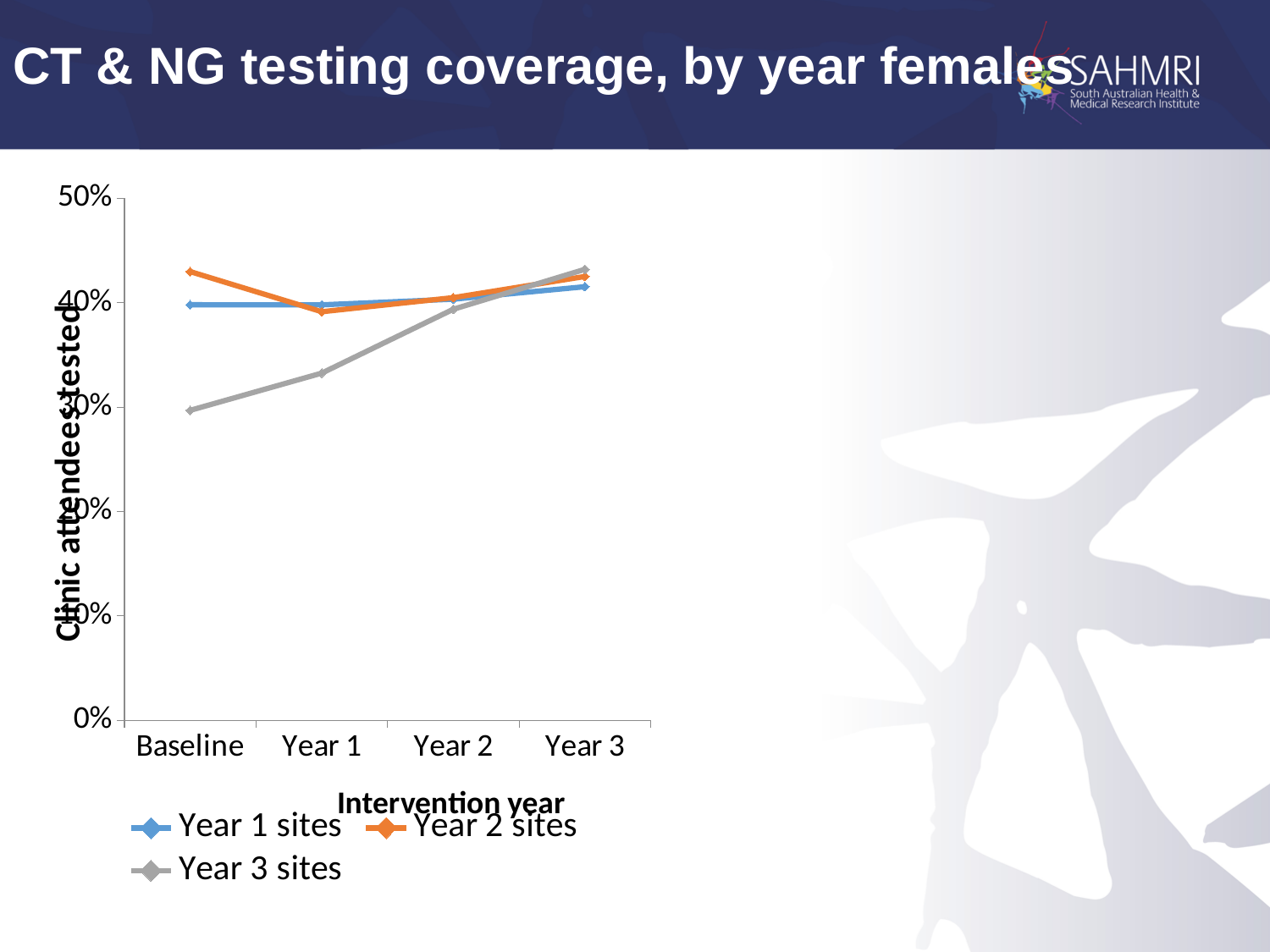
Which series has the lowest value at Year 1? Year 3 sites Is the value for Year 3 sites at Year 3 greater or less than 40%? greater What is the title of the x axis? Intervention year Is the value for Year 3 sites at Year 1 greater or less than 30%? greater What kind of chart is shown on the slide? line chart Which series has the highest value at Baseline? Year 2 sites How many series does the legend list? 3 At Baseline, which is larger: the value for Year 1 sites or the value for Year 3 sites? Year 1 sites Does the value for Year 3 sites rise or fall from Baseline to Year 3? rise How many points are plotted along the x axis for each series? 4 Which series has the lowest value at Baseline? Year 3 sites Is the value for Year 2 sites at Baseline greater or less than 40%? greater